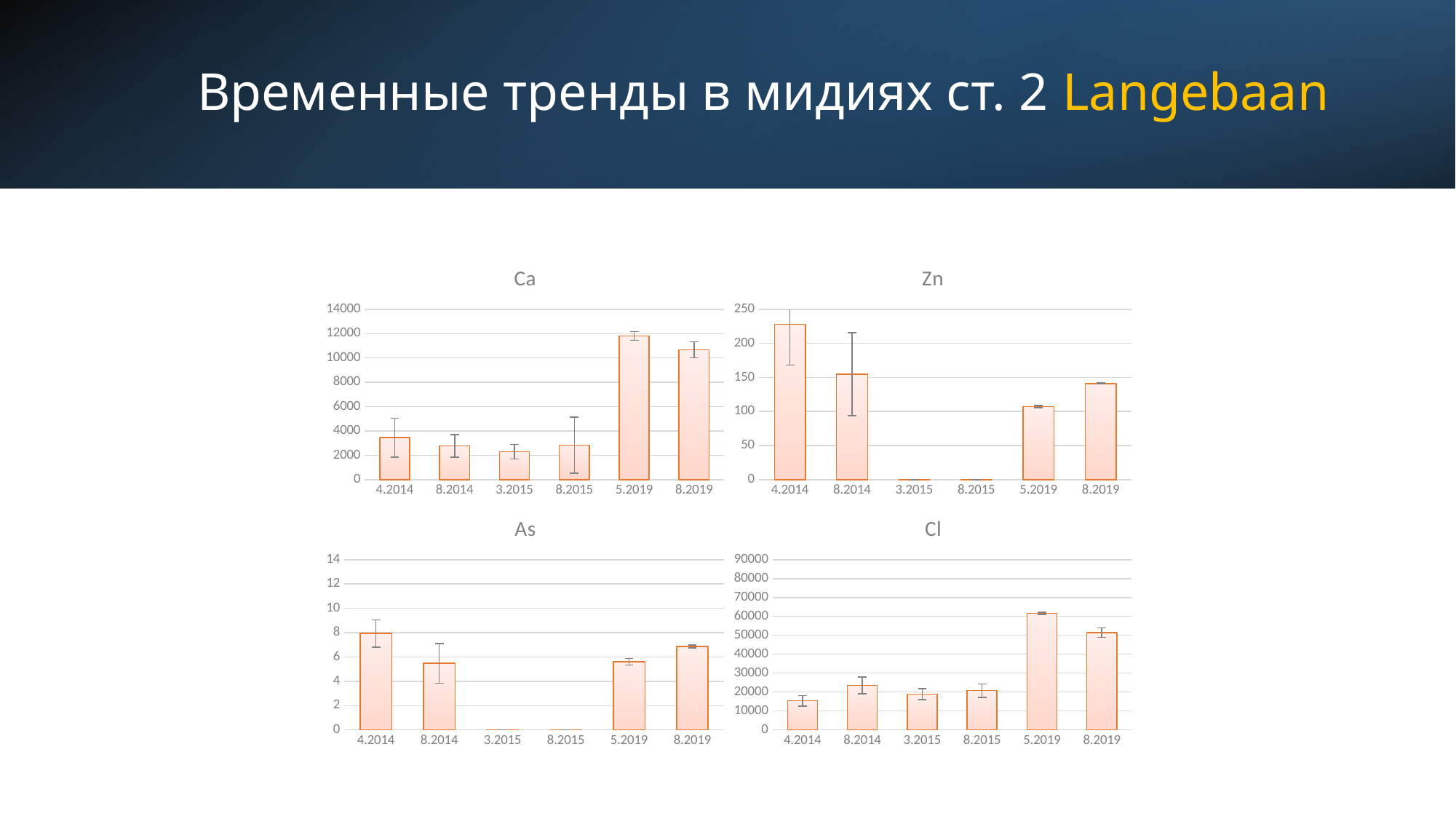
In the Cl chart, which time point has the lowest value? 4.2014 In the Zn chart, is the value for 4.2014 greater or less than 200? greater In the Ca chart, which time point has the highest value? 5.2019 What type of chart is the Ca chart? bar chart In the As chart, is the value for 8.2019 greater or less than 6? greater How many time points are shown on the x axis of the Zn chart? 6 How many charts are shown on the slide? 4 In the As chart, which time point has the highest value? 4.2014 In the Zn chart, which is larger, the value for 4.2014 or the value for 5.2019? 4.2014 In the Cl chart, which time point has the highest value? 5.2019 In the Ca chart, is the value for 5.2019 greater or less than 10000? greater